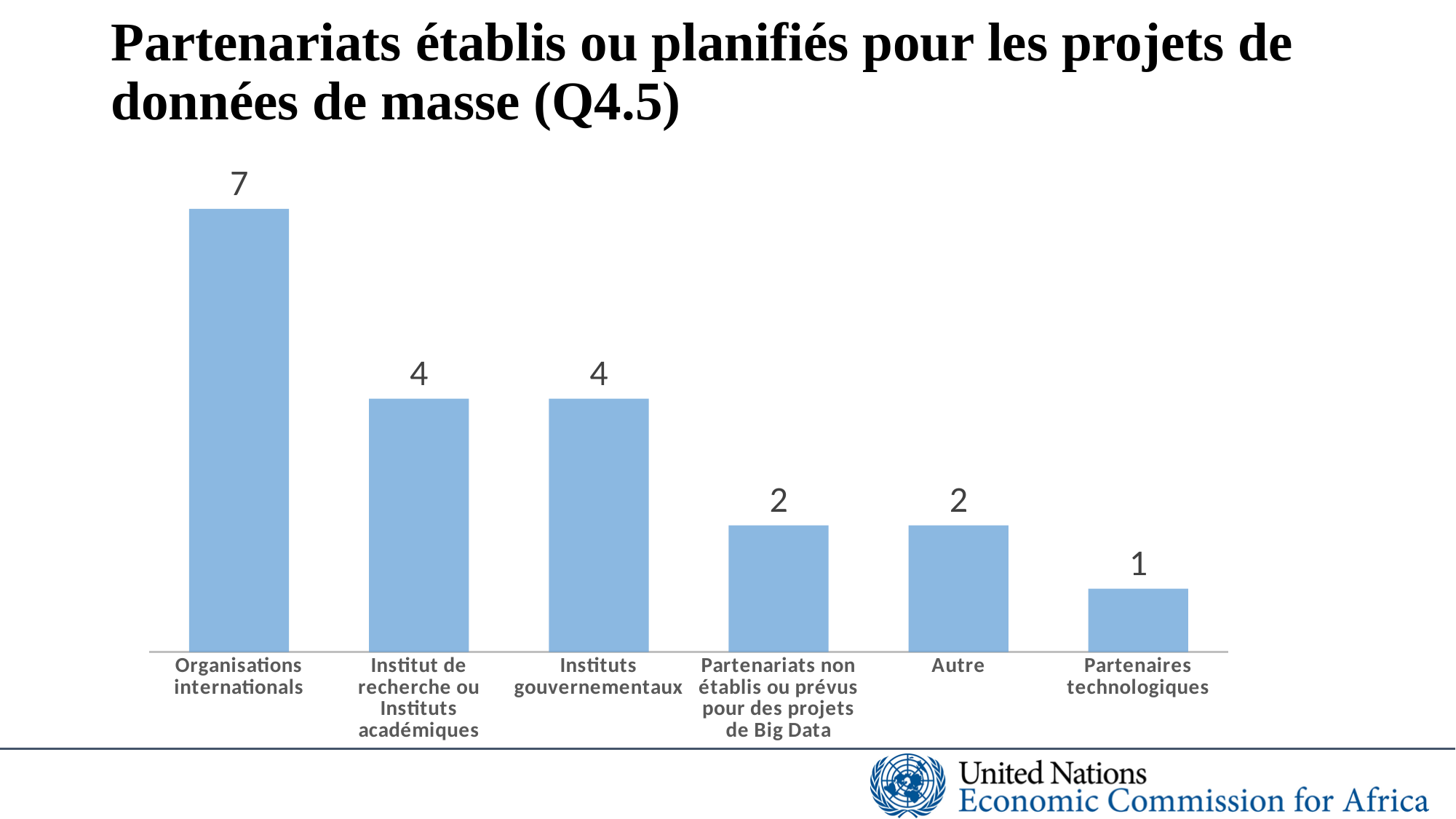
Which is larger, the value for Instituts gouvernementaux or the value for Autre? Instituts gouvernementaux What is the value for Autre? 2 Which category has the highest value? Organisations internationals What is the value for Organisations internationals? 7 Do the values rise or fall from left to right along the x axis? Fall How many categories are shown in the chart? 6 What is the difference between the values for Organisations internationals and Institut de recherche ou Instituts académiques? 3 What is the title of the slide? Partenariats établis ou planifiés pour les projets de données de masse (Q4.5) What kind of chart is shown on the slide? Bar chart Which category has the lowest value? Partenaires technologiques What is the value for Instituts gouvernementaux? 4 What is the value for Partenaires technologiques? 1